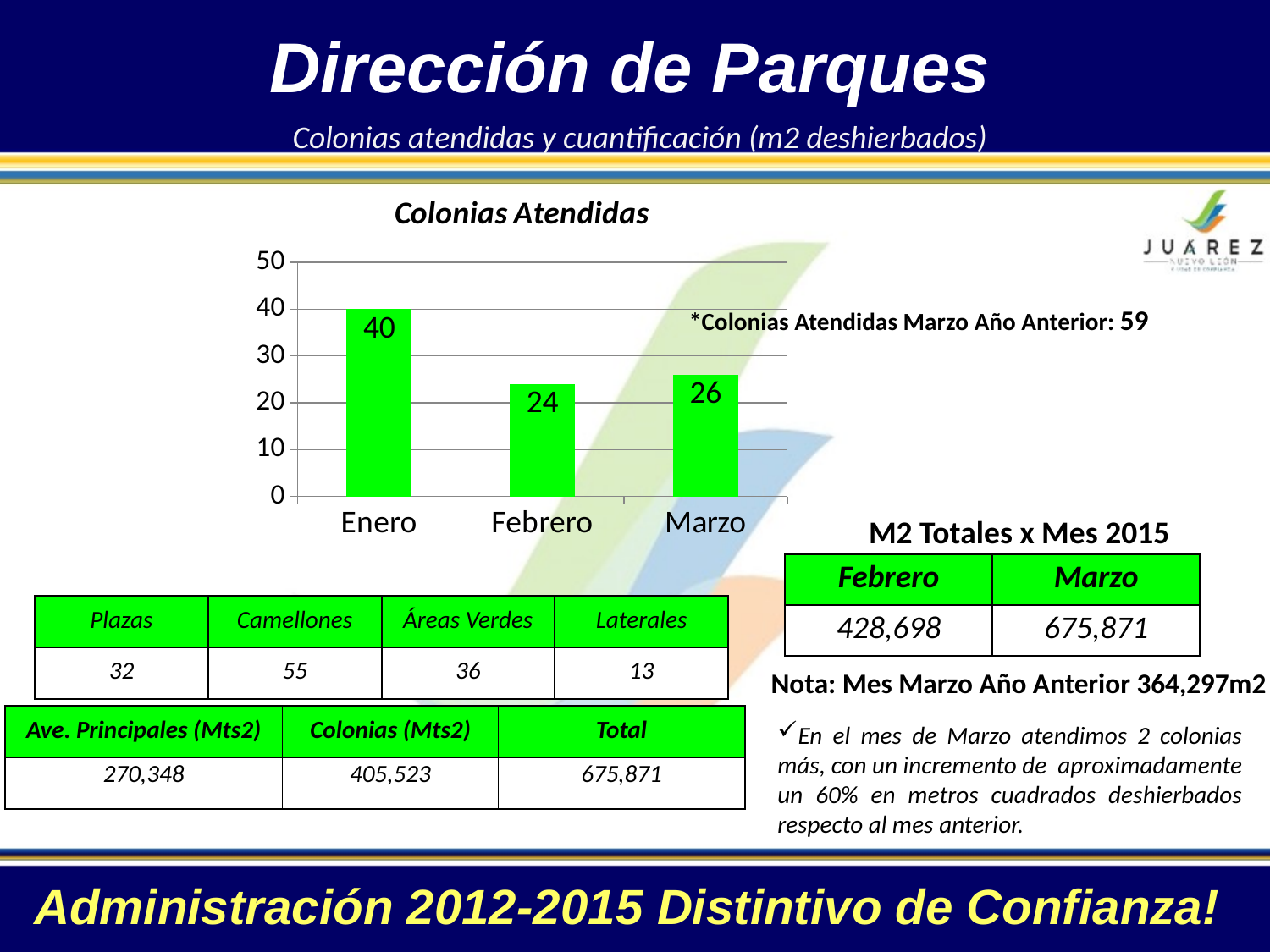
Which is larger in the Colonias Atendidas chart, the value for Enero or the value for Marzo? Enero What is the title of the chart on the slide? Colonias Atendidas What is the difference between the values for Enero and Febrero in the Colonias Atendidas chart? 16 What is the value for Enero in the Colonias Atendidas chart? 40 Which month has the highest value in the Colonias Atendidas chart? Enero How many months are shown in the Colonias Atendidas chart? 3 What is the value for Febrero in the Colonias Atendidas chart? 24 Which month has the lowest value in the Colonias Atendidas chart? Febrero What kind of chart is the Colonias Atendidas chart? bar chart What is the value for Marzo in the Colonias Atendidas chart? 26 Is the value for Enero in the Colonias Atendidas chart greater or less than 30? greater What is the difference between the values for Marzo and Febrero in the Colonias Atendidas chart? 2